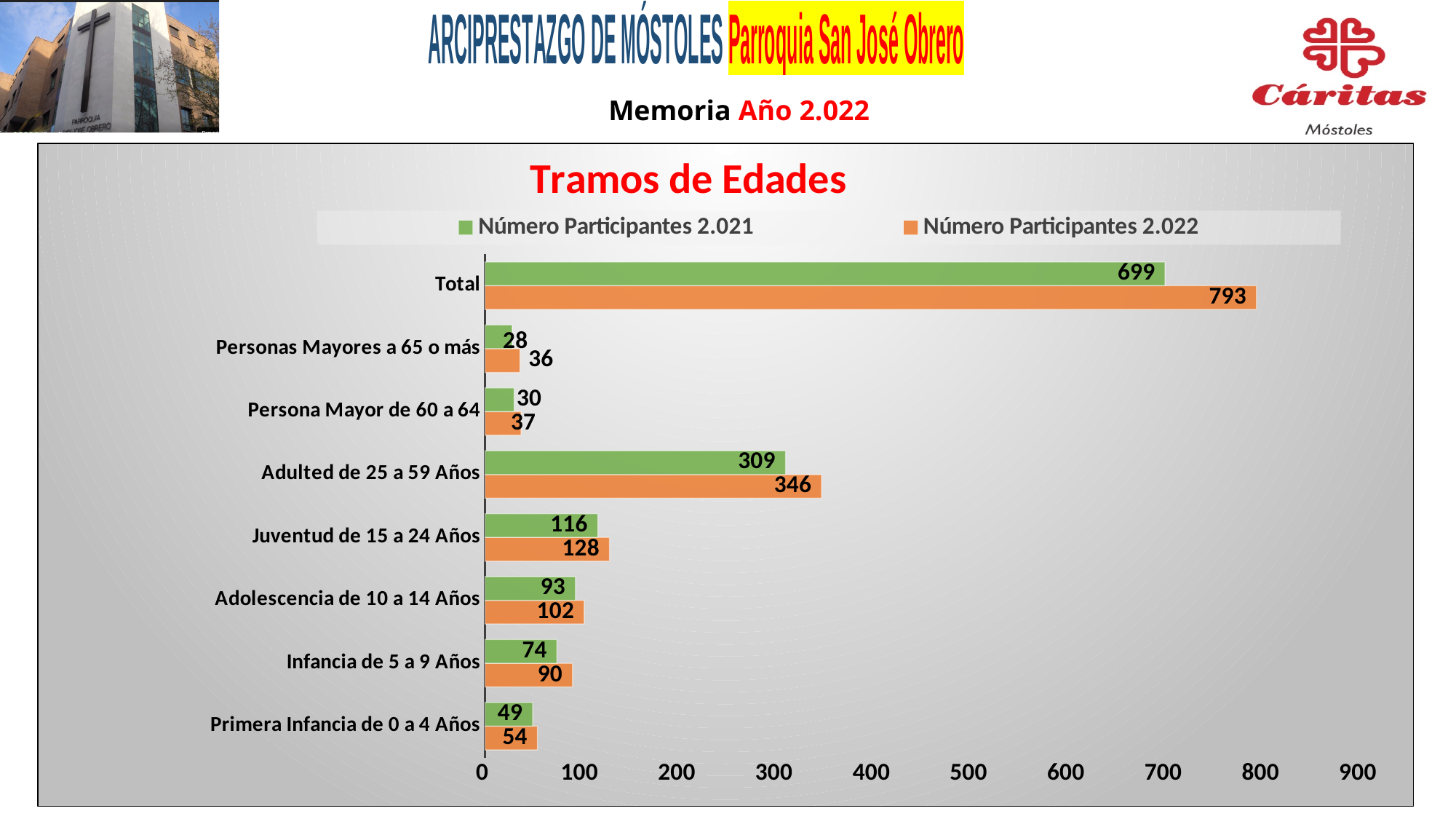
Excluding Total, which category has the highest value for Número Participantes 2.021? Adulted de 25 a 59 Años What is the value for Número Participantes 2.022 for Adulted de 25 a 59 Años? 346 What is the value for Número Participantes 2.021 for Juventud de 15 a 24 Años? 116 How many series does the legend list? 2 What is the title of the chart? Tramos de Edades What kind of chart is shown on the slide? Bar chart Which is larger for Adolescencia de 10 a 14 Años: Número Participantes 2.021 or Número Participantes 2.022? Número Participantes 2.022 How many categories are shown on the y axis of the chart? 8 What is the difference between the Total values for Número Participantes 2.022 and Número Participantes 2.021? 94 Excluding Total, which category has the lowest value for Número Participantes 2.022? Personas Mayores a 65 o más What is the difference between Número Participantes 2.022 and Número Participantes 2.021 for Infancia de 5 a 9 Años? 16 What is the Total value for Número Participantes 2.022? 793